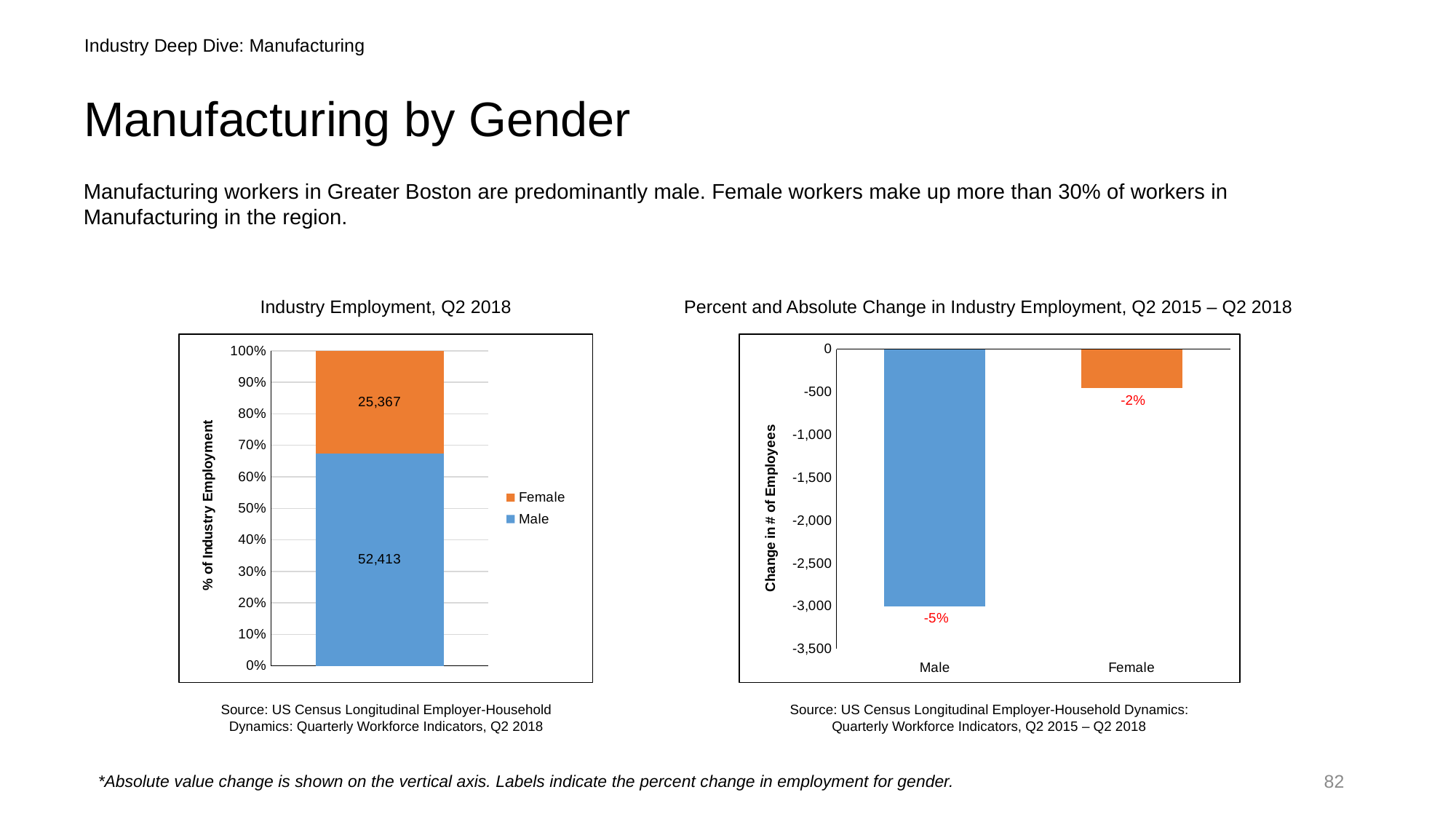
How many categories are shown on the x axis of the 'Percent and Absolute Change in Industry Employment, Q2 2015 – Q2 2018' chart? 2 In the 'Percent and Absolute Change in Industry Employment, Q2 2015 – Q2 2018' chart, what percent change label is shown for Male? -5% In the 'Industry Employment, Q2 2018' chart, what is the value shown for Male? 52,413 In the 'Percent and Absolute Change in Industry Employment, Q2 2015 – Q2 2018' chart, which category shows the larger decline in number of employees? Male In the 'Industry Employment, Q2 2018' chart, what is the difference between the Male and Female values? 27,046 In the 'Industry Employment, Q2 2018' chart, which series has the larger value, Male or Female? Male In the 'Industry Employment, Q2 2018' chart, what is the total of the Male and Female values in the stacked bar? 77,780 In the 'Percent and Absolute Change in Industry Employment, Q2 2015 – Q2 2018' chart, is the change in number of employees for Male greater or less than -2,500? less In the 'Industry Employment, Q2 2018' chart, what is the value shown for Female? 25,367 How many series does the legend of the 'Industry Employment, Q2 2018' chart list? 2 What kind of chart is the 'Industry Employment, Q2 2018' chart? Stacked bar chart In the 'Percent and Absolute Change in Industry Employment, Q2 2015 – Q2 2018' chart, what percent change label is shown for Female? -2%